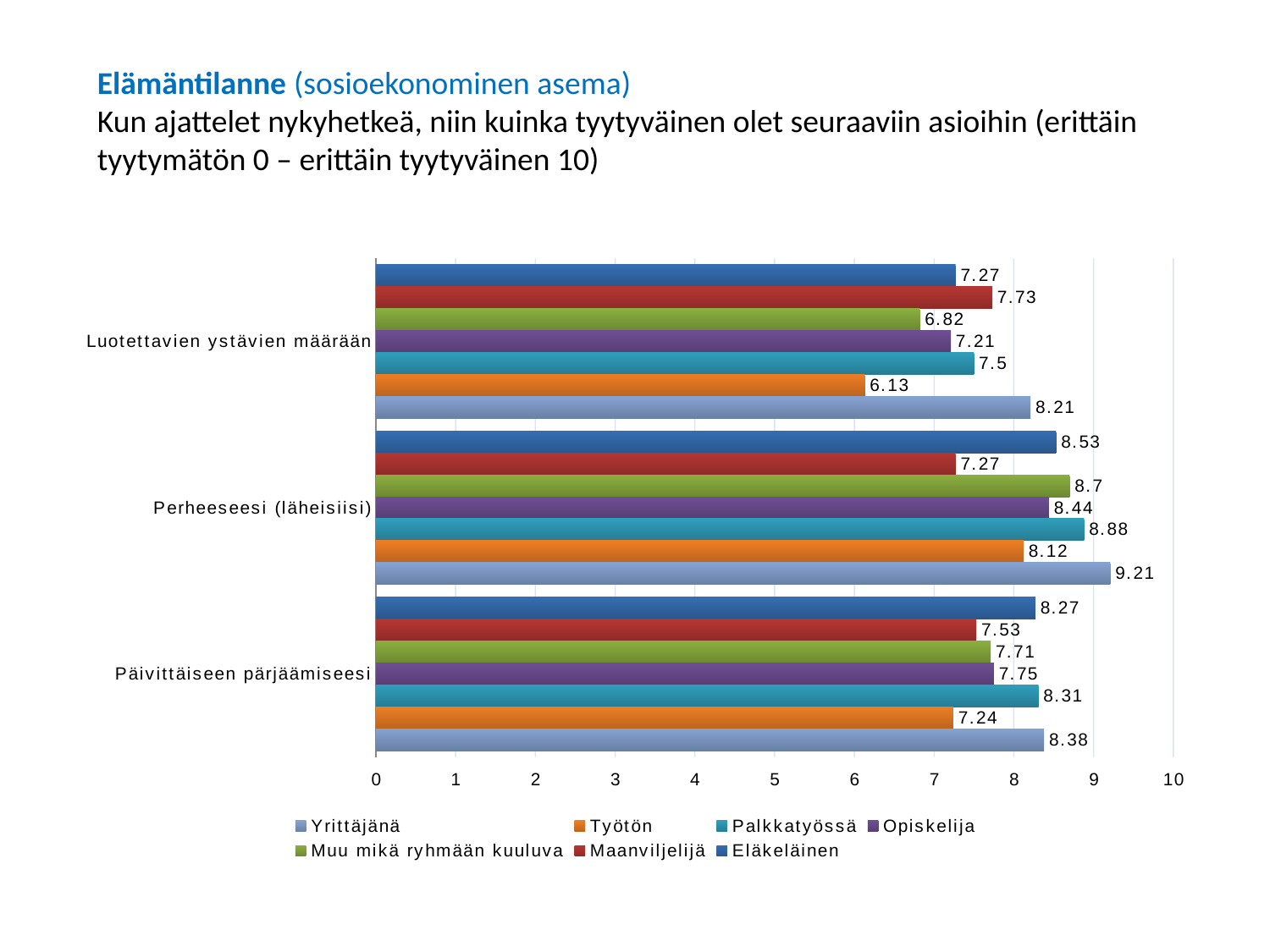
What kind of chart is shown on the slide? Bar chart What is the value for Työtön in the Luotettavien ystävien määrään category? 6.13 What is the value for Eläkeläinen in the Perheeseesi (läheisiisi) category? 8.53 How many categories are shown on the vertical axis? 3 Which series has the highest value in the Luotettavien ystävien määrään category? Yrittäjänä How many series does the legend list? 7 Which series has the lowest value in the Perheeseesi (läheisiisi) category? Maanviljelijä What is the value for Yrittäjänä in the Perheeseesi (läheisiisi) category? 9.21 What is the value for Palkkatyössä in the Päivittäiseen pärjäämiseesi category? 8.31 In the Päivittäiseen pärjäämiseesi category, which is larger: Opiskelija or Maanviljelijä? Opiskelija Which series is shown in orange in the legend? Työtön What is the difference between the Yrittäjänä and Työtön values in the Luotettavien ystävien määrään category? 2.08